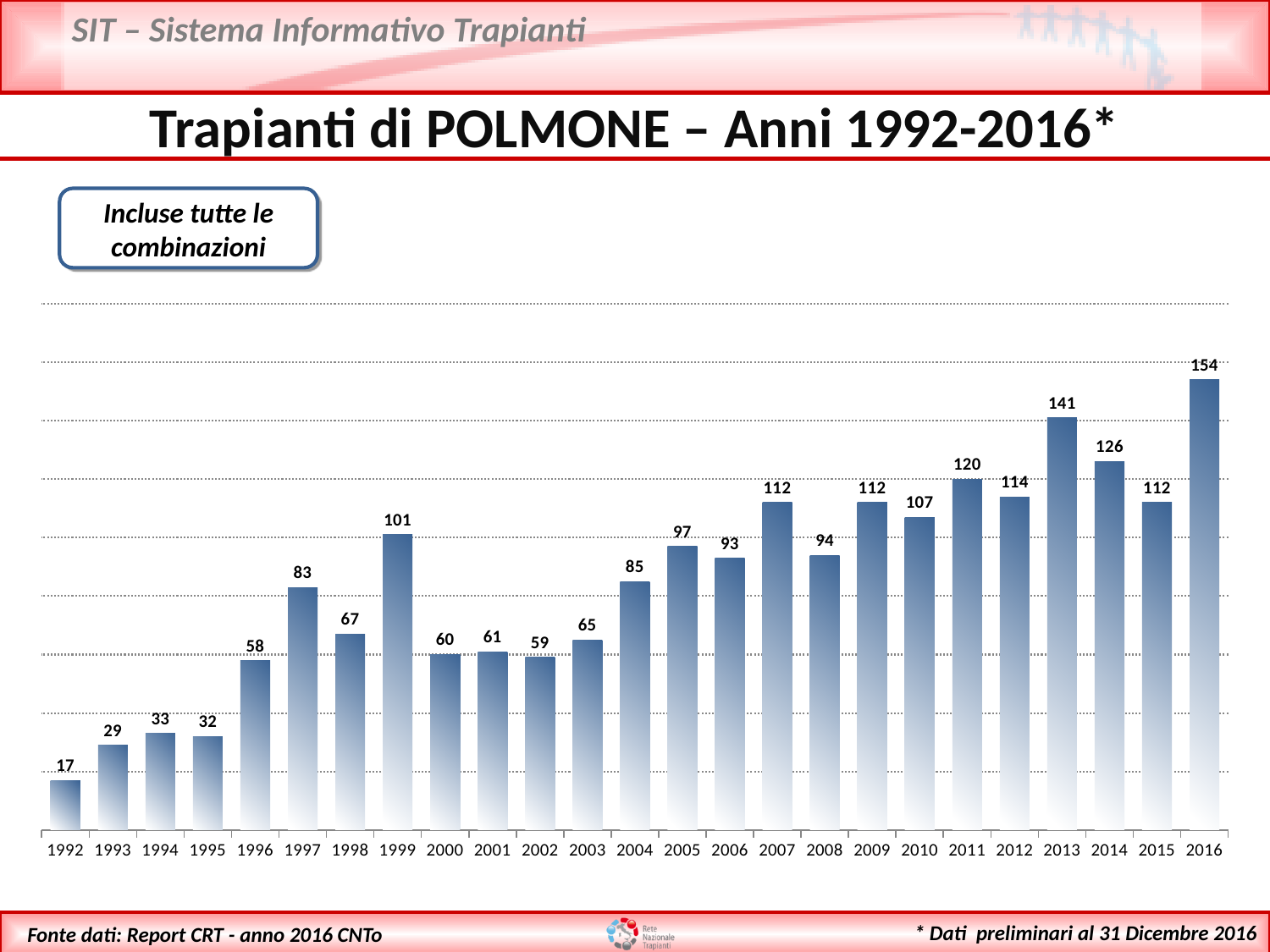
Which year has the highest value? 2016 Which is larger, the value for 1997 or the value for 2004? 2004 What kind of chart is shown on the slide? Bar chart Which is larger, the value for 2011 or the value for 2012? 2011 Which year has the lowest value? 1992 What is the difference between the values for 2013 and 2014? 15 What is the title of the slide's chart? Trapianti di POLMONE – Anni 1992-2016* What is the difference between the values for 2016 and 2015? 42 What is the value for 1999? 101 How many years are shown on the x axis? 25 What is the value for 1992? 17 What is the value for 2010? 107